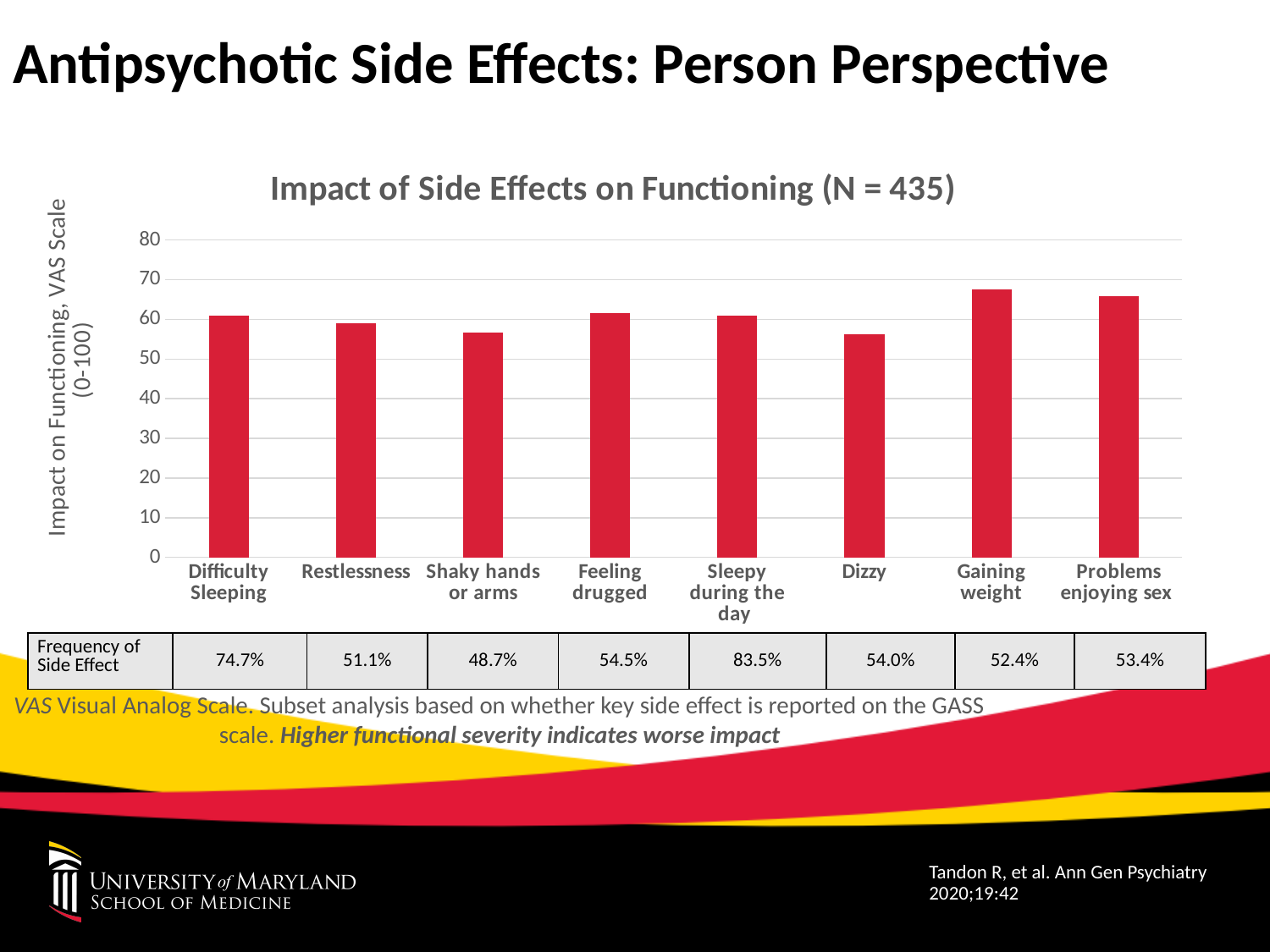
What type of chart is shown on the slide? Bar chart Which side effect has the highest impact on functioning in the chart? Gaining weight Is the impact on functioning value for Dizzy greater or less than 60? less What is the difference in frequency between Sleepy during the day and Difficulty Sleeping in the table under the chart? 8.8 percentage points According to the table under the chart, what is the frequency of the side effect Sleepy during the day? 83.5% Which has a larger impact on functioning, Restlessness or Shaky hands or arms? Restlessness How many side-effect categories are plotted in the chart? 8 Is the impact on functioning value for Gaining weight greater or less than 60? greater According to the table under the chart, which side effect has the lowest frequency? Shaky hands or arms Is the impact on functioning value for Shaky hands or arms greater or less than 50? greater What is the title of the chart? Impact of Side Effects on Functioning (N = 435) Which has a larger impact on functioning, Gaining weight or Dizzy? Gaining weight